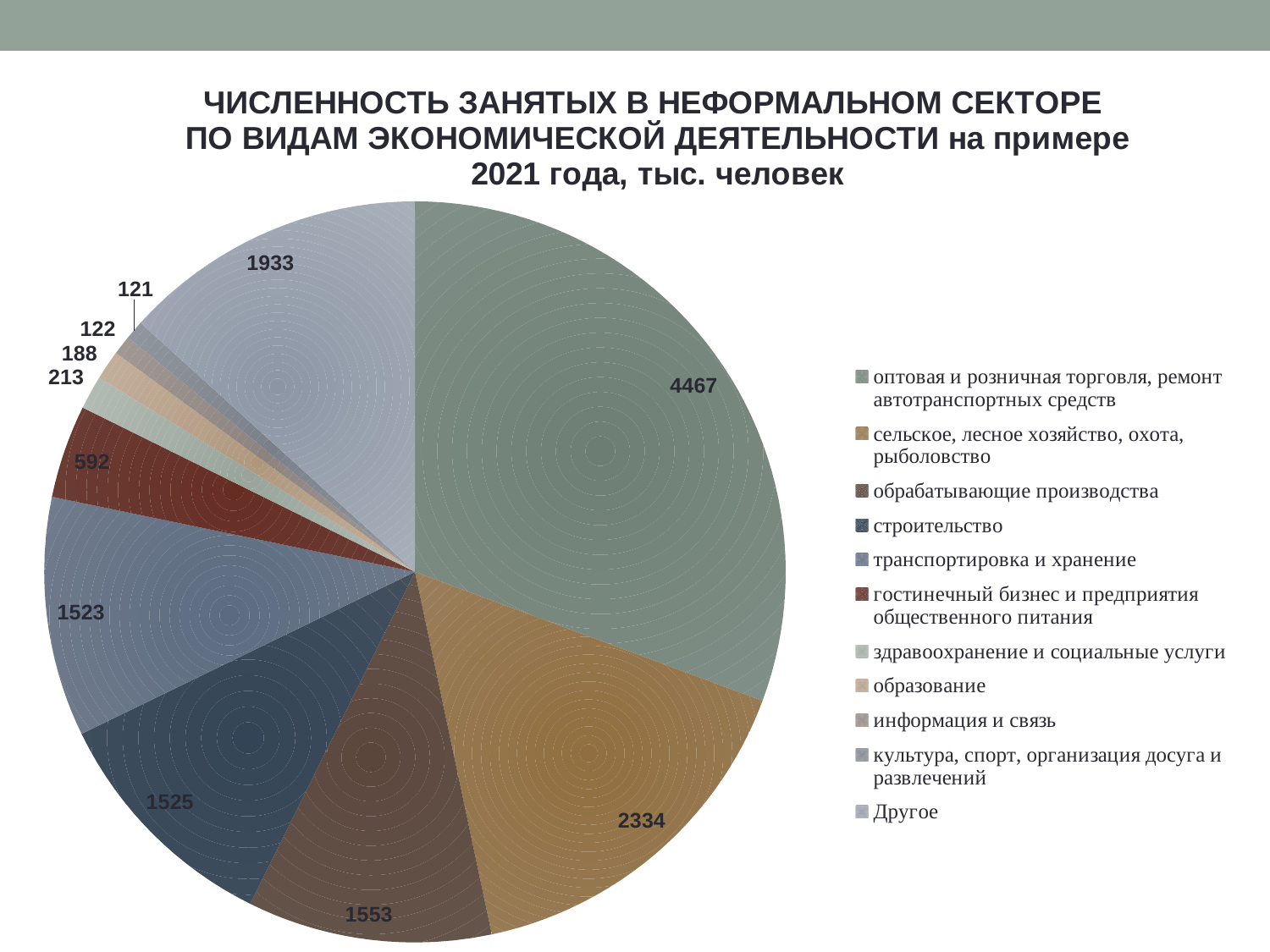
What is the value for the Другое slice? 1933 What kind of chart is shown on the slide? Pie chart What is the value for гостиничный бизнес и предприятия общественного питания? 592 How many slices does the pie chart have? 11 What is the difference between the values for оптовая и розничная торговля and сельское, лесное хозяйство, охота, рыболовство? 2133 What unit of measurement is stated in the chart title? тыс. человек What is the value for оптовая и розничная торговля, ремонт автотранспортных средств? 4467 What is the value for образование? 188 Which category has the smallest slice of the pie? культура, спорт, организация досуга и развлечений What is the value for сельское, лесное хозяйство, охота, рыболовство? 2334 Which category has the largest slice of the pie? оптовая и розничная торговля, ремонт автотранспортных средств Which is larger: the value for обрабатывающие производства or the value for гостиничный бизнес и предприятия общественного питания? обрабатывающие производства